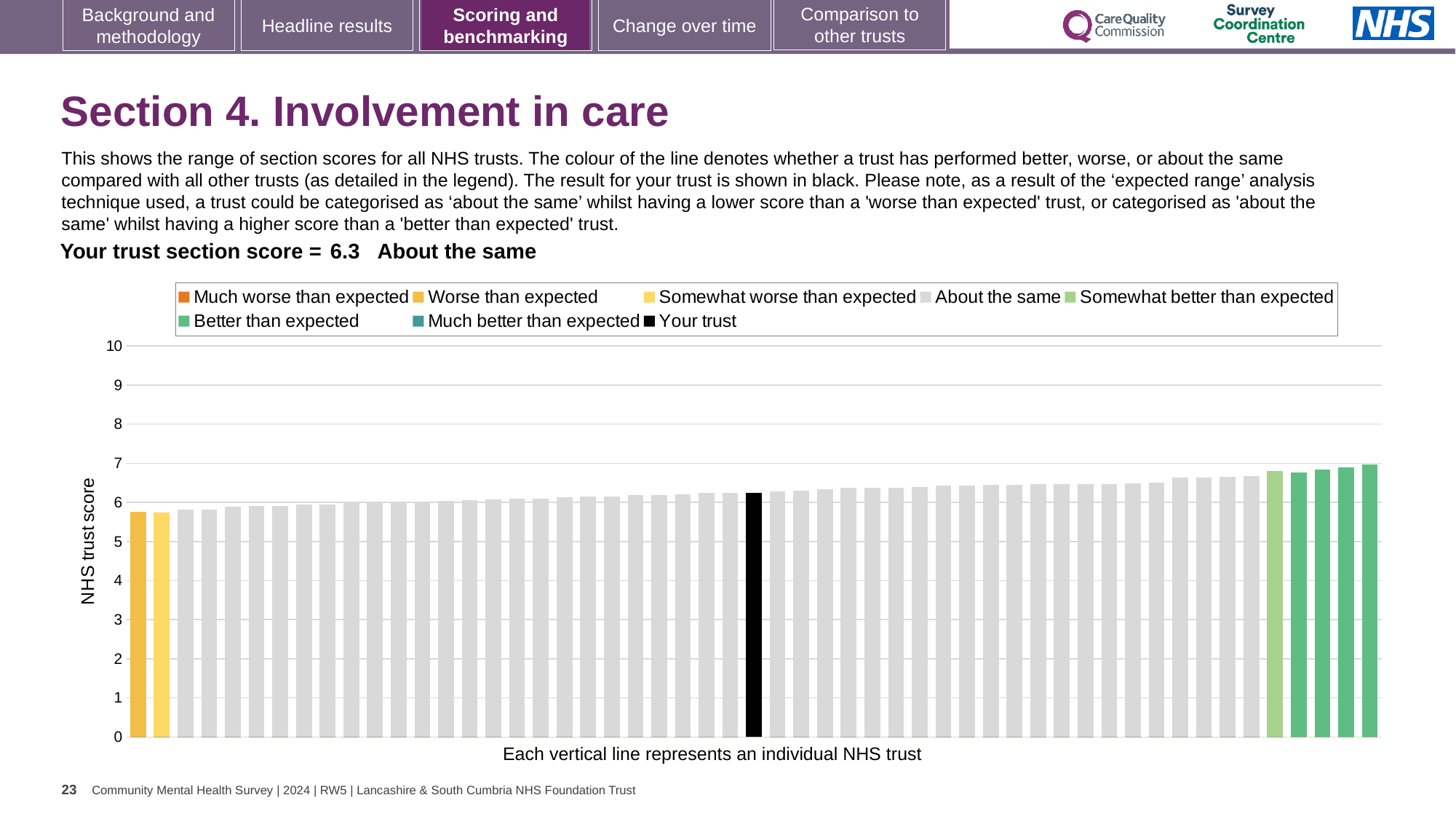
Is the value of the highest bar in the chart greater or less than 6? greater Is the value of the black 'Your trust' bar greater or less than 5? greater Is the value of the black 'Your trust' bar greater or less than 7? less What kind of chart is shown on the slide? bar chart How is the trust's section score categorised compared with other trusts? About the same How many bars are coloured as 'Better than expected' (green) in the chart? 4 How many entries does the chart legend list? 8 What is the label on the y axis of the chart? NHS trust score What is the trust's section score shown on the slide? 6.3 Do the bar values rise or fall from left to right along the x axis? rise